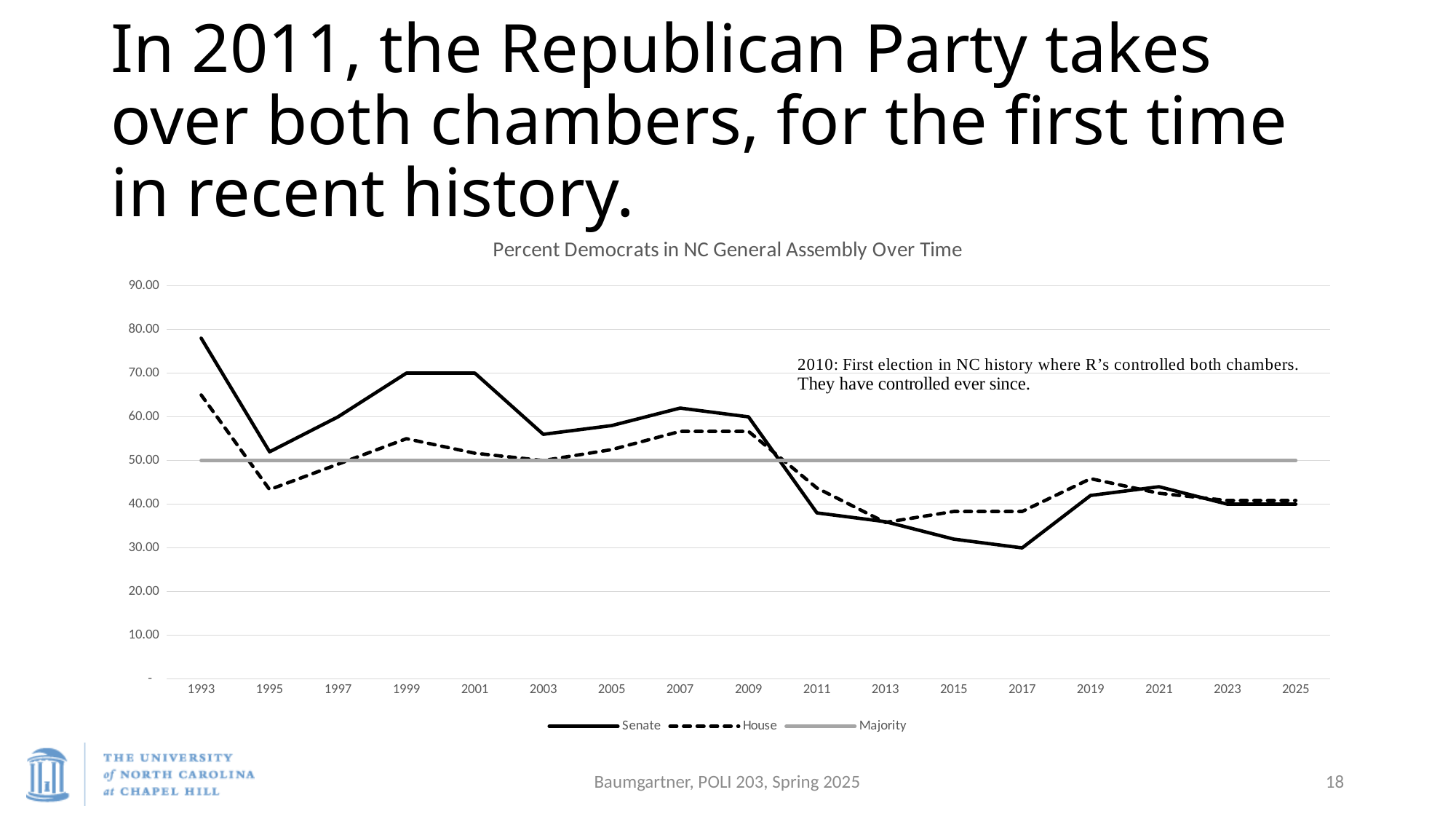
What kind of chart is shown on the slide? line chart Is the House value in 1995 greater or less than 50? less In which year is the Senate value highest? 1993 How many years are shown along the x axis of the chart? 17 Is the Senate value in 1993 greater or less than 70? greater What is the value of the Majority line on the chart? 50.00 Does the Senate line rise or fall from 2011 to 2017? fall What is the title of the chart? Percent Democrats in NC General Assembly Over Time What is the Senate value in 2017? 30.00 In 2015, which series has the larger value, Senate or House? House How many series does the chart legend list? 3 In which year is the Senate value lowest? 2017